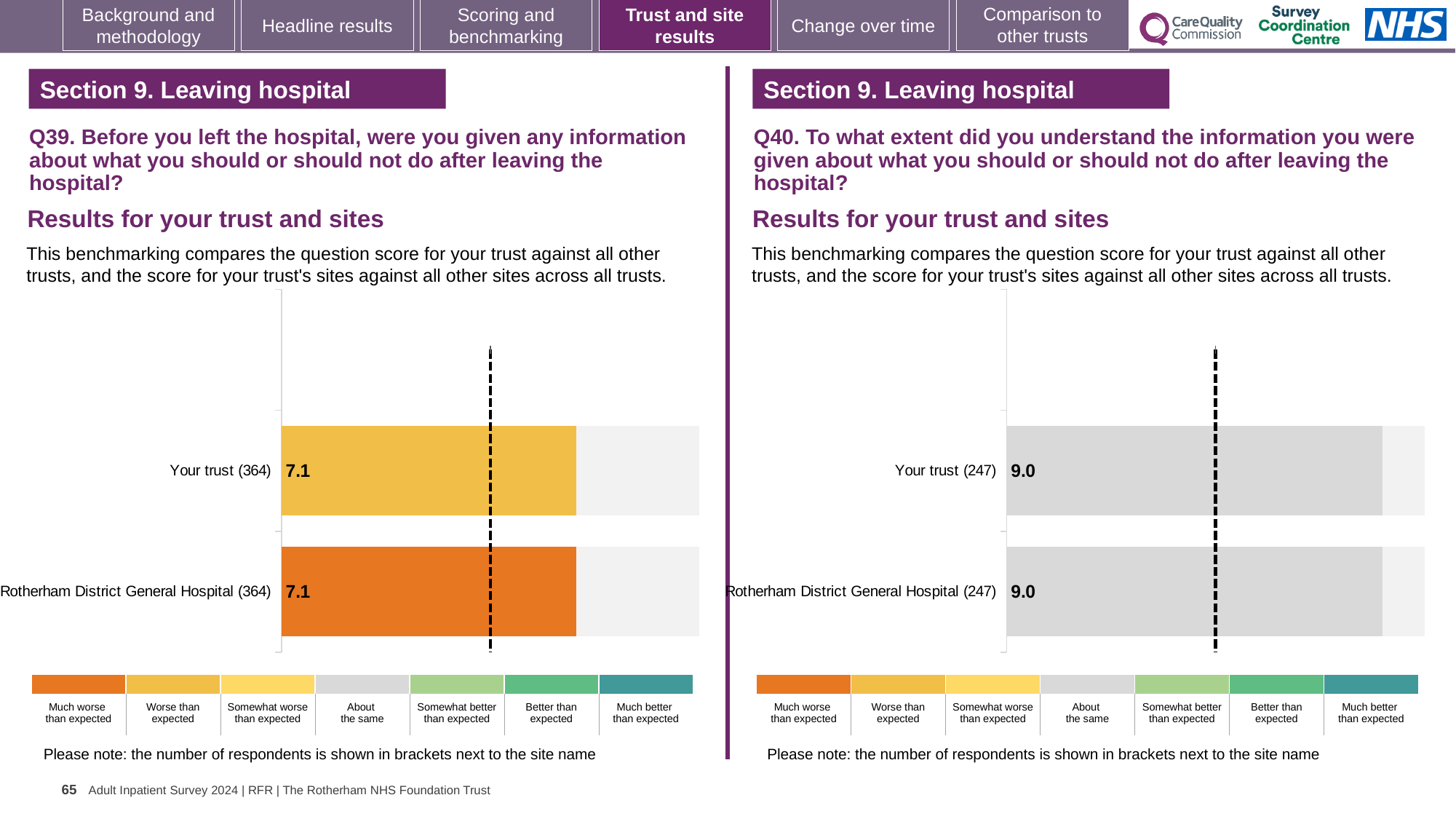
What kind of chart is the Q39 chart on the left? Bar chart In the Q40 chart on the right, which benchmark category does the colour of the Your trust bar correspond to? About the same In the Q40 chart on the right, what is the score for Your trust? 9.0 In the Q39 chart on the left, how many respondents are shown in brackets for Your trust? 364 In the Q40 chart on the right, how many bars are plotted? 2 In the Q39 chart on the left, which benchmark category does the colour of the Rotherham District General Hospital bar correspond to? Much worse than expected In the Q39 chart on the left, what is the difference between the score for Your trust and the score for Rotherham District General Hospital? 0.0 In the Q39 chart on the left, what is the score for Your trust? 7.1 In the Q40 chart on the right, what is the score for Rotherham District General Hospital? 9.0 In the Q39 chart on the left, what is the score for Rotherham District General Hospital? 7.1 In the Q40 chart on the right, how many respondents are shown in brackets for Rotherham District General Hospital? 247 How many benchmark categories are listed in the colour key below the Q40 chart on the right? 7